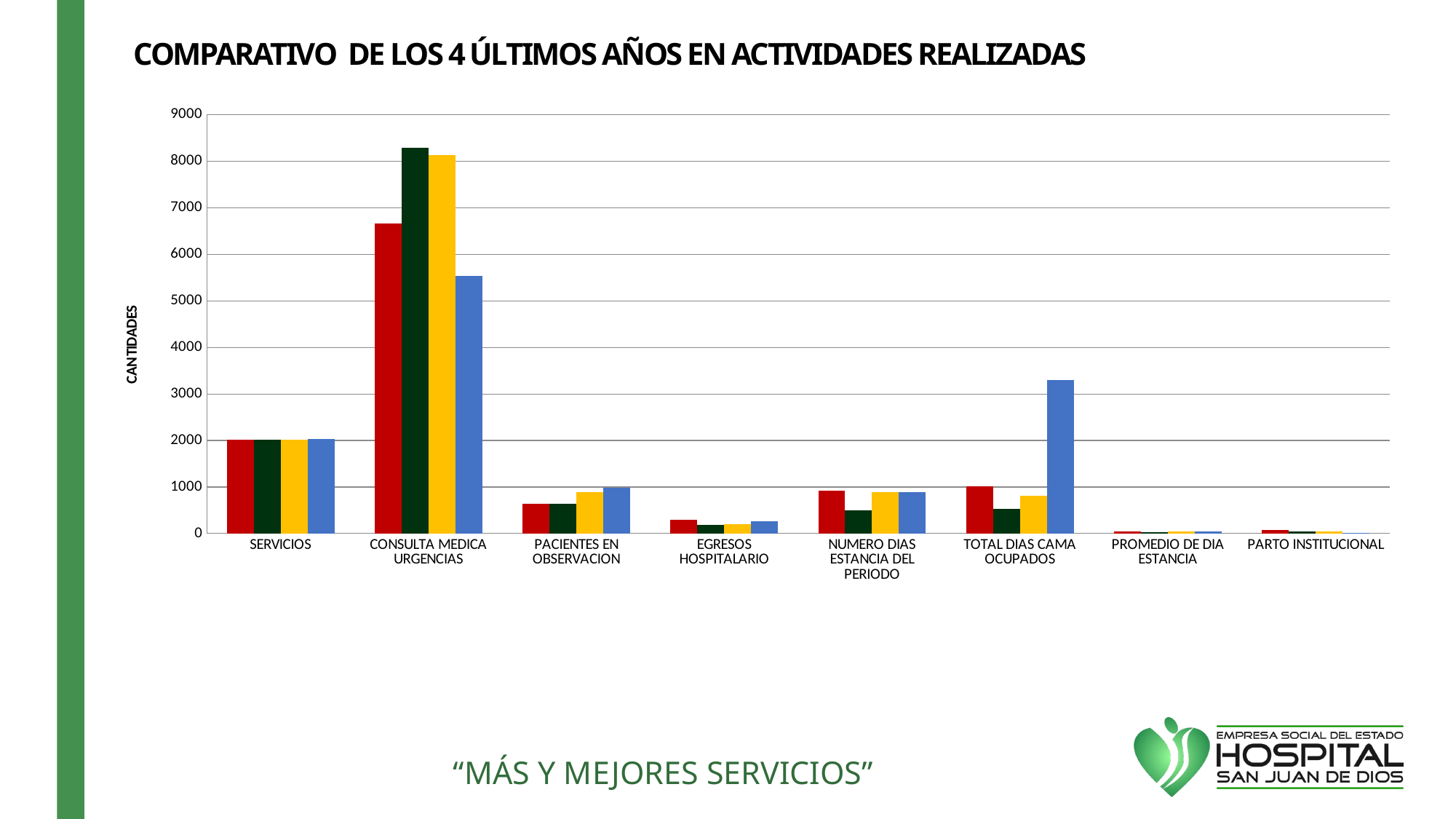
What is the title of the vertical axis of the chart? CANTIDADES Is the value of the red bar for EGRESOS HOSPITALARIO greater or less than 1000? less For CONSULTA MEDICA URGENCIAS, which bar is taller, the dark green bar or the blue bar? the dark green bar What is the title of the chart on the slide? COMPARATIVO DE LOS 4 ÚLTIMOS AÑOS EN ACTIVIDADES REALIZADAS Is the value of the blue bar for CONSULTA MEDICA URGENCIAS greater or less than 6000? less How many categories are shown along the x axis of the chart? 8 What kind of chart is shown on the slide? bar chart Is the value of the blue bar for TOTAL DIAS CAMA OCUPADOS greater or less than 3000? greater For TOTAL DIAS CAMA OCUPADOS, which bar is taller, the blue bar or the red bar? the blue bar For PACIENTES EN OBSERVACION, which bar is taller, the blue bar or the red bar? the blue bar Which category has the tallest bar in the chart? CONSULTA MEDICA URGENCIAS